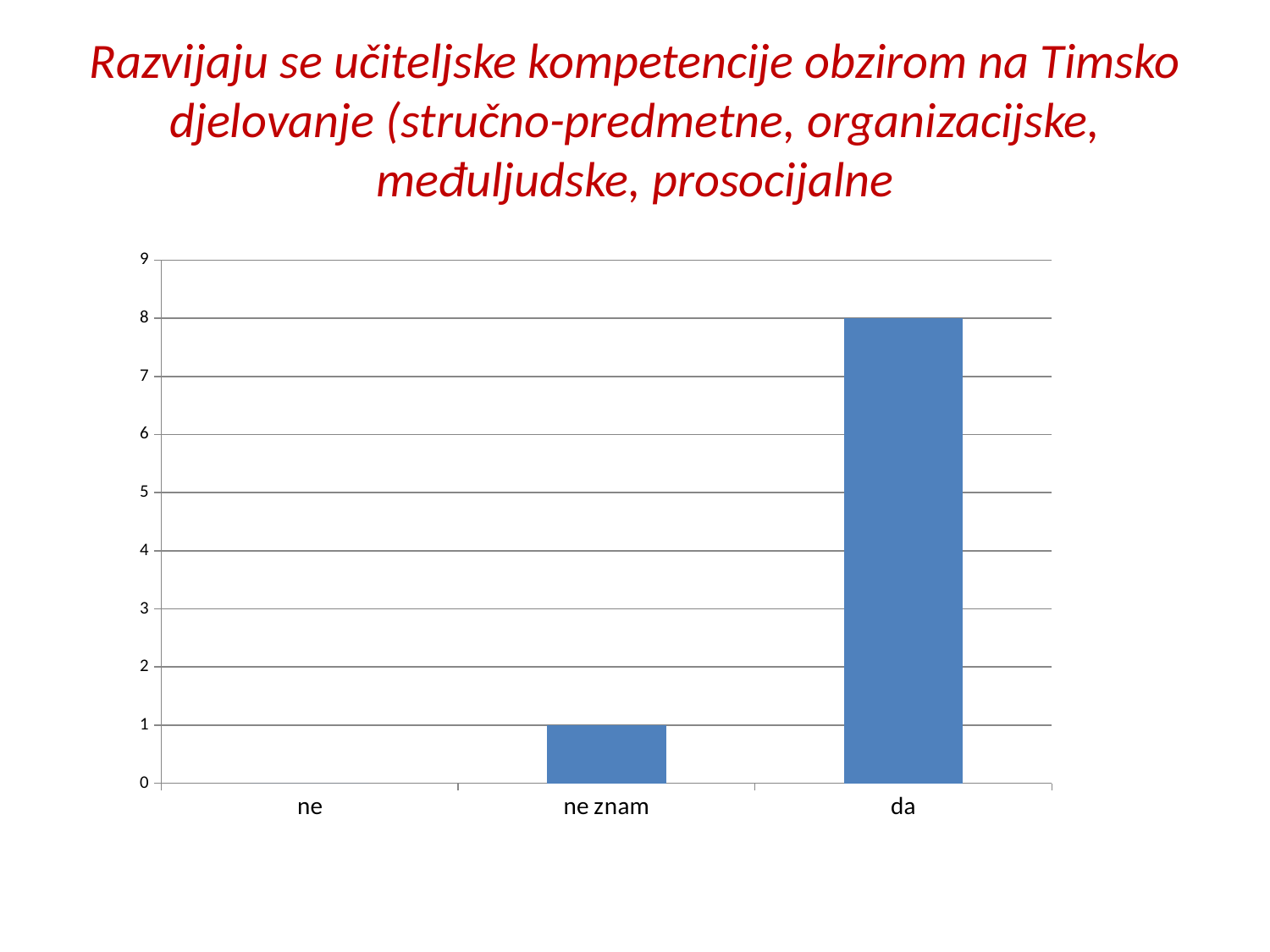
Do the values rise or fall from left to right along the x axis? rise How many categories are shown on the x axis? 3 Is the value for "da" greater or less than 5? greater Which category has the lowest value? ne What is the value for "da"? 8 What is the highest value shown on the vertical axis? 9 What kind of chart is shown on the slide? bar chart Which is larger, the value for "ne znam" or the value for "da"? da What is the value for "ne znam"? 1 Which category has the highest value? da What is the value for "ne"? 0 What is the difference between the values for "da" and "ne znam"? 7